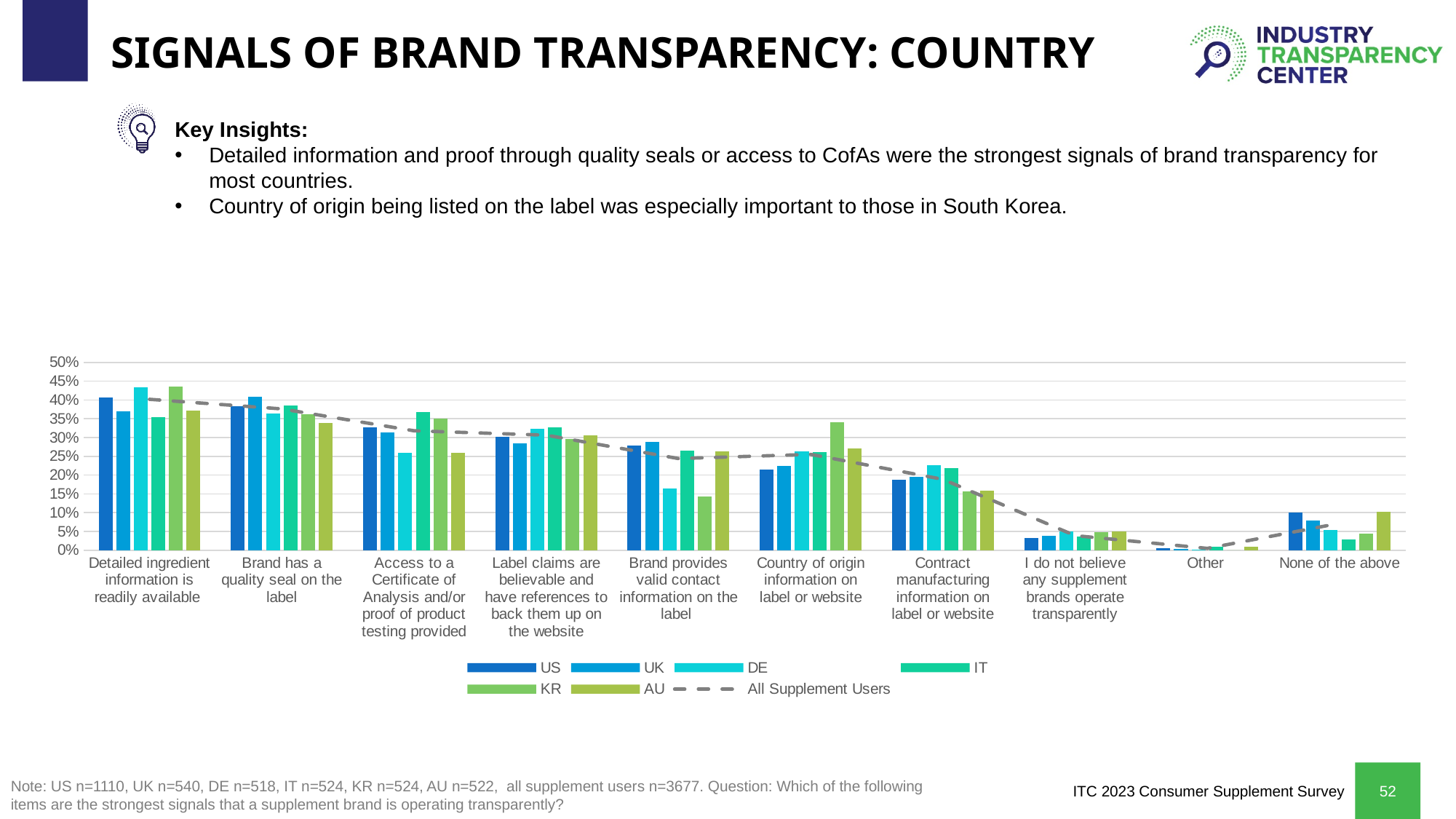
What kind of chart is shown on the slide? combination bar and line chart Is the DE value for 'Detailed ingredient information is readily available' greater or less than 40%? greater Which legend entry is shown as a dashed line rather than a bar? All Supplement Users How many series does the chart's legend list? 7 Is the DE value for 'Brand provides valid contact information on the label' greater or less than 20%? less Does the 'All Supplement Users' dashed line generally rise or fall from 'Detailed ingredient information is readily available' to 'Other'? fall Is the KR value for 'Country of origin information on label or website' greater or less than 30%? greater How many categories are shown along the x axis of the chart? 10 For 'Access to a Certificate of Analysis and/or proof of product testing provided', which is larger, the IT value or the DE value? IT Which country has the highest value for 'Country of origin information on label or website'? KR